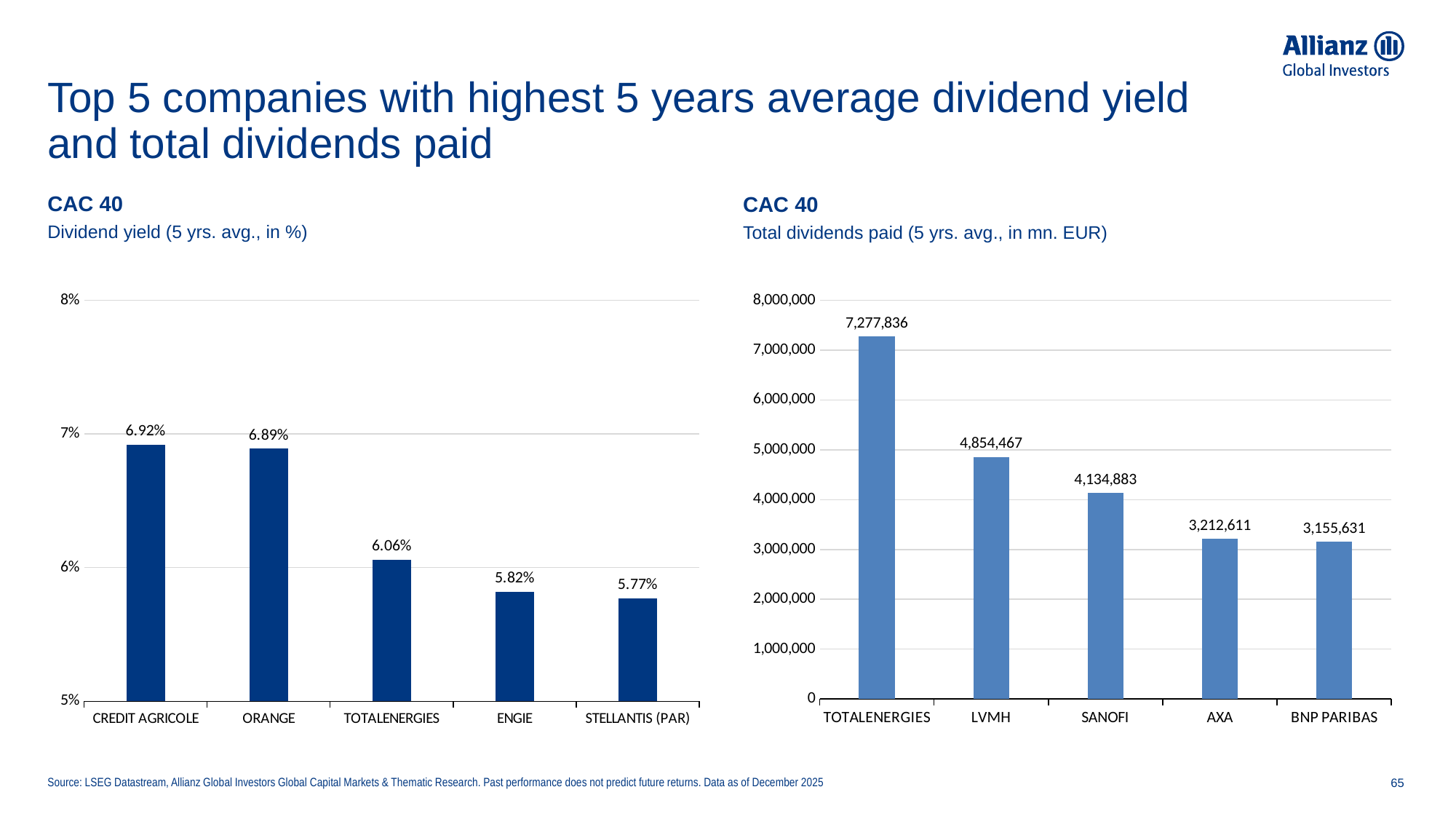
In the dividend yield chart on the left, what is the difference between CREDIT AGRICOLE and STELLANTIS (PAR)? 1.15 percentage points In the total dividends paid chart on the right, what is the value for SANOFI? 4,134,883 In the total dividends paid chart on the right, what is the difference between TOTALENERGIES and LVMH? 2,423,369 In the dividend yield chart on the left, what is the value for TOTALENERGIES? 6.06% In the dividend yield chart on the left, which company has the highest value? CREDIT AGRICOLE In the dividend yield chart on the left, is the value for ENGIE greater or less than 6%? less How many companies are shown in the dividend yield chart on the left? 5 In the total dividends paid chart on the right, which company has the lowest value? BNP PARIBAS In the total dividends paid chart on the right, which is larger, AXA or BNP PARIBAS? AXA In the total dividends paid chart on the right, is the value for LVMH greater or less than 5,000,000? less What type of chart is the total dividends paid chart on the right? Bar chart In the total dividends paid chart on the right, do the values rise or fall from left to right? Fall